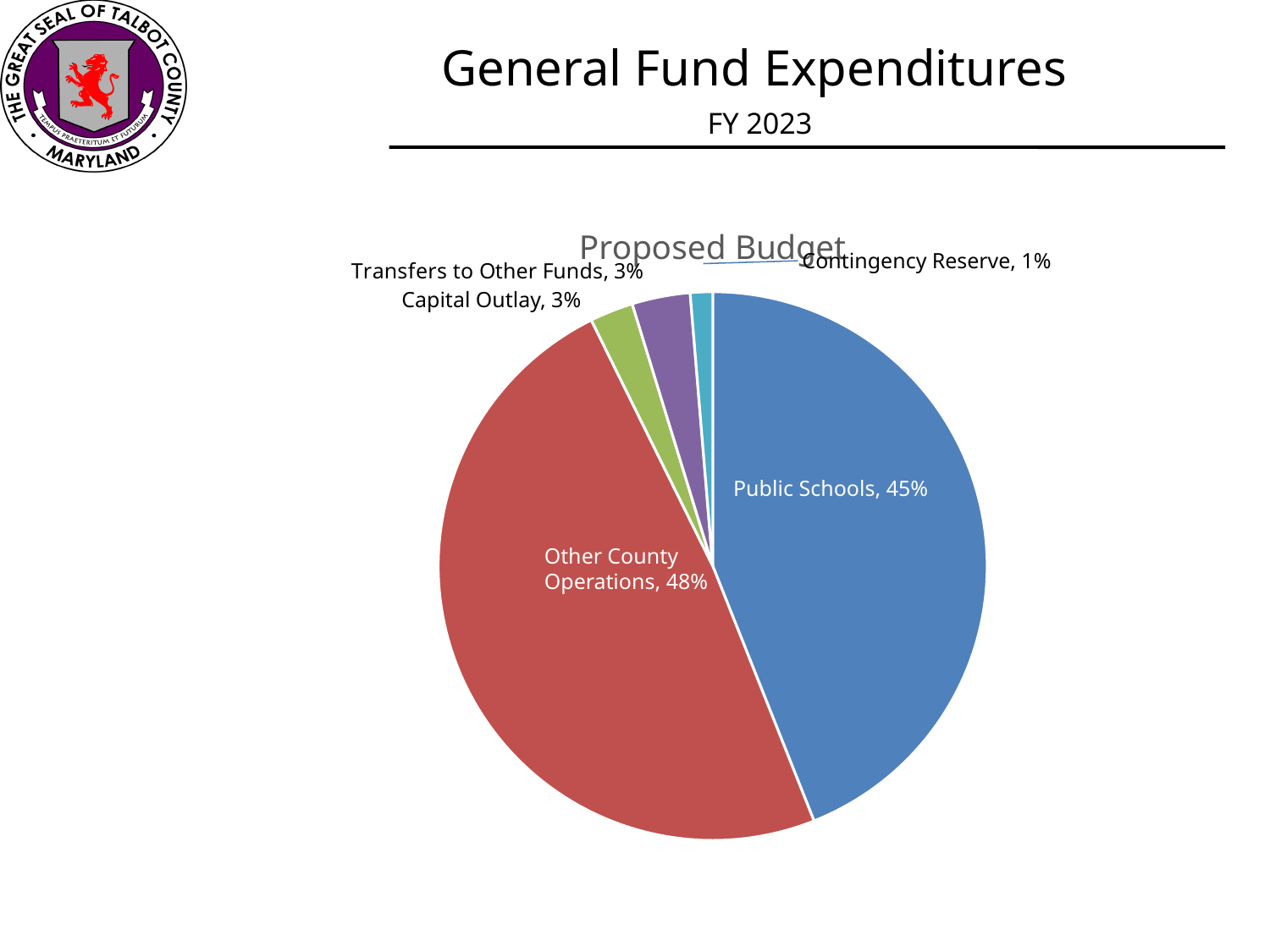
What share of the pie does Other County Operations represent? 48% What is the title of the pie chart? Proposed Budget Which category has the largest slice of the pie? Other County Operations What is the value shown for Capital Outlay? 3% Which is larger, the share for Public Schools or the share for Capital Outlay? Public Schools What is the difference between the Other County Operations share and the Public Schools share? 3% What share of the pie does Public Schools represent? 45% How many slices does the pie chart have? 5 What is the value shown for Transfers to Other Funds? 3% What kind of chart is shown on the slide? pie chart Which category has the smallest slice of the pie? Contingency Reserve What is the value shown for Contingency Reserve? 1%